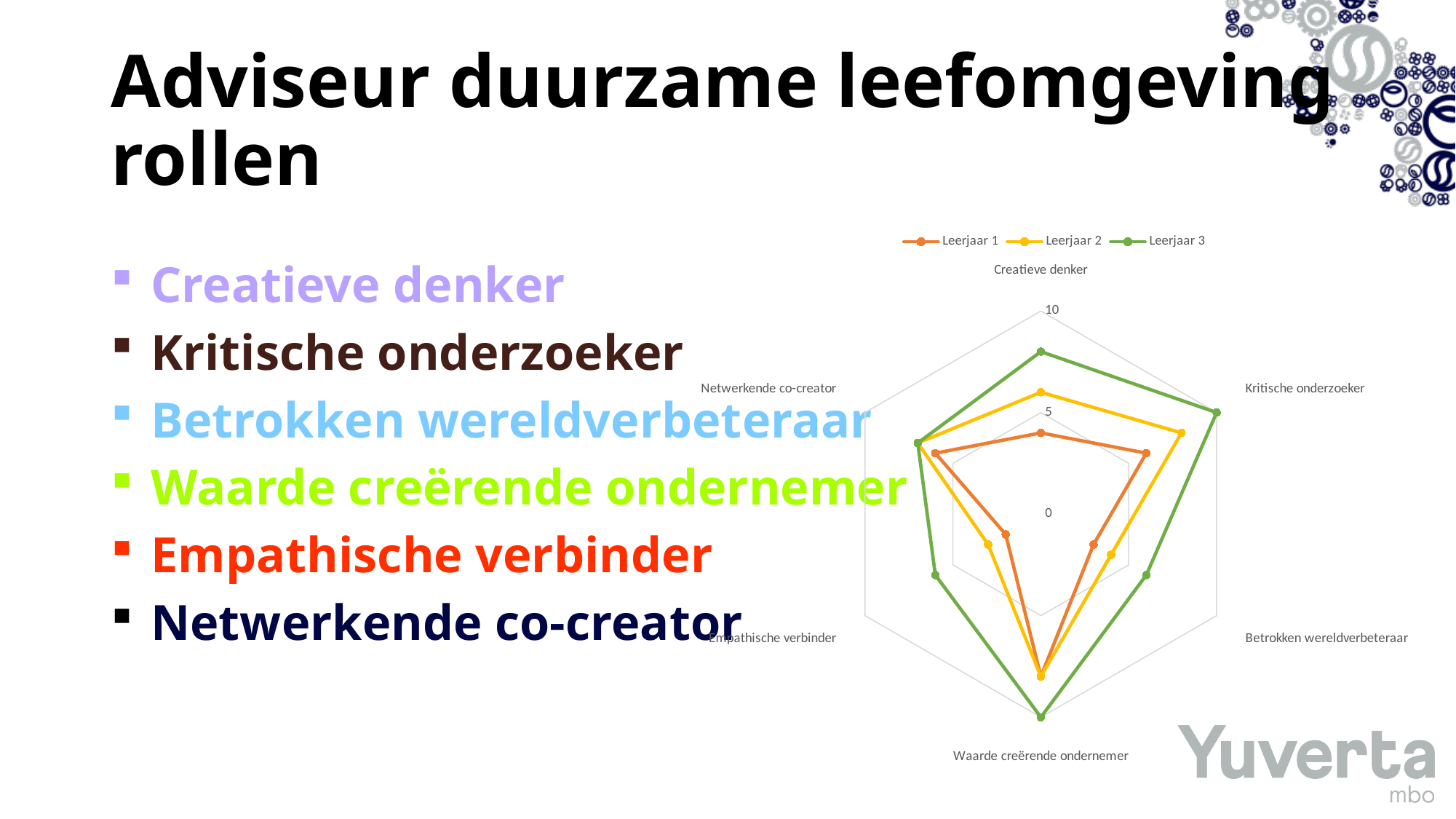
Which series are listed in the chart legend? Leerjaar 1, Leerjaar 2, Leerjaar 3 What kind of chart is shown on the slide? Radar chart For Creatieve denker, which series has the larger value: Leerjaar 1 or Leerjaar 3? Leerjaar 3 Is the value of Leerjaar 1 for Empathische verbinder greater or less than 5? less Is the value of Leerjaar 1 for Creatieve denker greater or less than 5? less How many series does the chart legend list? 3 How many categories (axes) does the radar chart have? 6 Is the value of Leerjaar 3 for Kritische onderzoeker greater or less than 5? greater What is the highest value shown on the chart's axis scale? 10 For the Leerjaar 1 series, which category has the highest value? Waarde creërende ondernemer